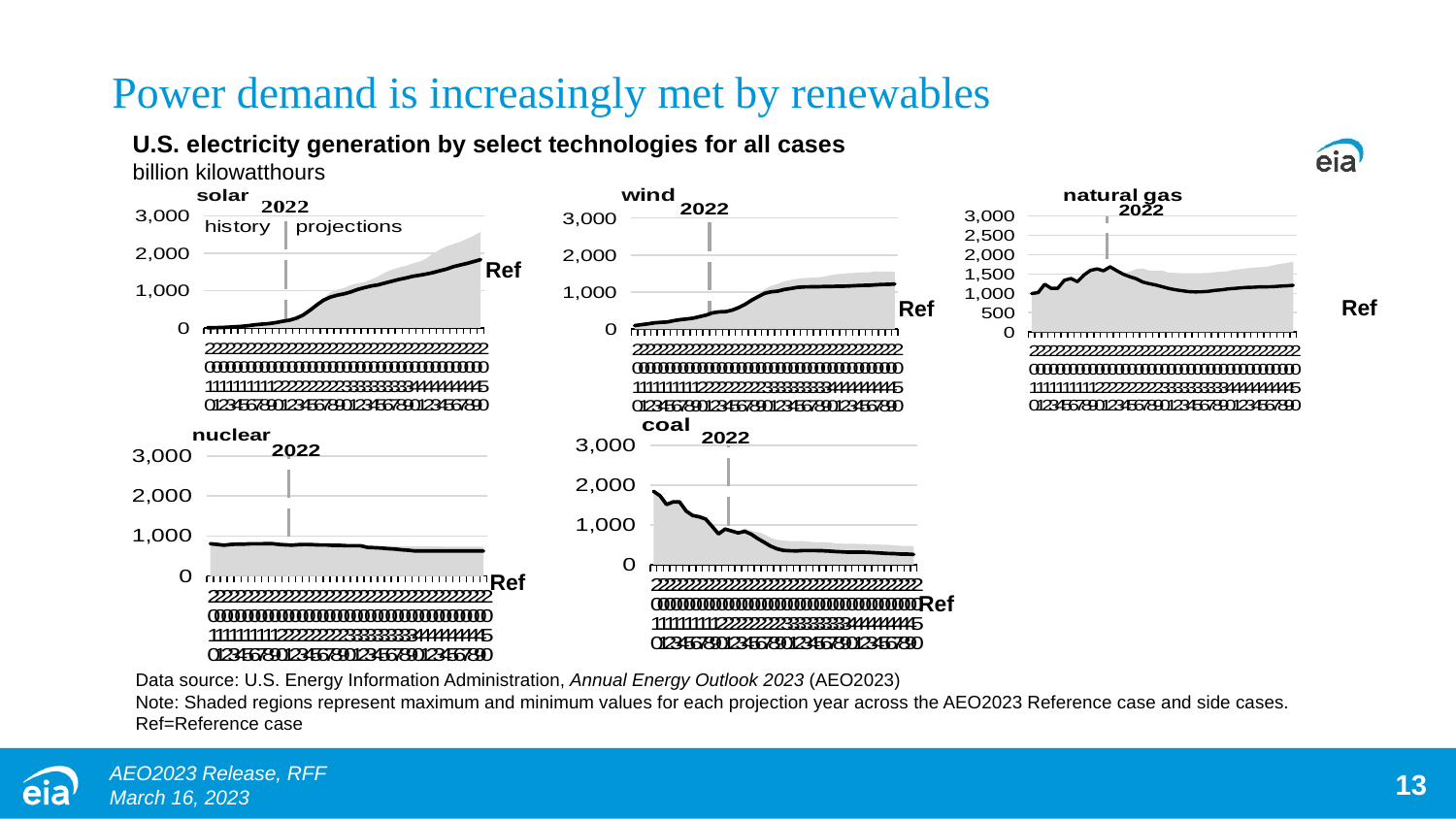
What unit are the charts measured in? billion kilowatthours At the end of the projection period, which is larger: the solar Ref value or the nuclear Ref value? solar In the natural gas chart, is the highest point of the Ref line greater or less than 1,000? greater In the wind chart, does the Ref line rise or fall from the start to the end of the x axis? rise In the coal chart, does the Ref line rise or fall along the x axis? fall In the solar chart, does the Ref line rise or fall over the projection period? rise How many separate charts are shown on the slide? 5 In the coal chart, is the Ref value at the start of the history period greater or less than 1,000? greater Which year does the vertical dashed line in each chart mark as the boundary between history and projections? 2022 In the nuclear chart, is the Ref value at the end of the projection greater or less than 1,000? less What kind of chart is used for the solar panel? area and line chart